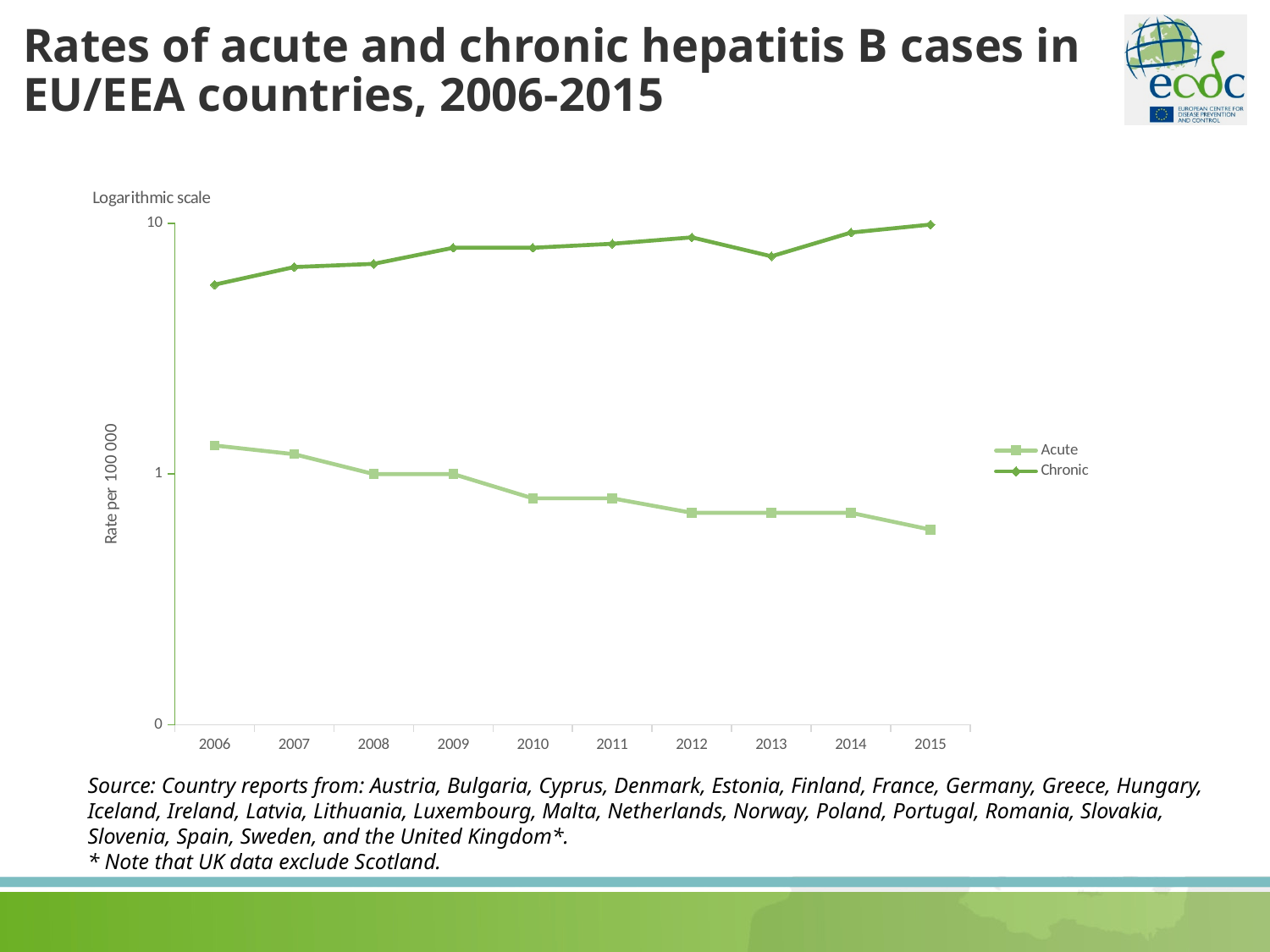
In which year is the Acute rate lowest? 2015 Is the Acute rate in 2015 greater or less than 1? less Does the Acute rate generally rise or fall from 2006 to 2015? Fall Which series has the higher rate in 2010, Acute or Chronic? Chronic In which year is the Chronic rate highest? 2015 What type of chart is shown on the slide? Line chart Is the Acute rate in 2006 greater or less than 1? greater How many series does the legend list? 2 In which year is the Chronic rate lowest? 2006 Is the Chronic rate in 2006 greater or less than 10? less How many years are plotted along the x axis? 10 In which year is the Acute rate highest? 2006